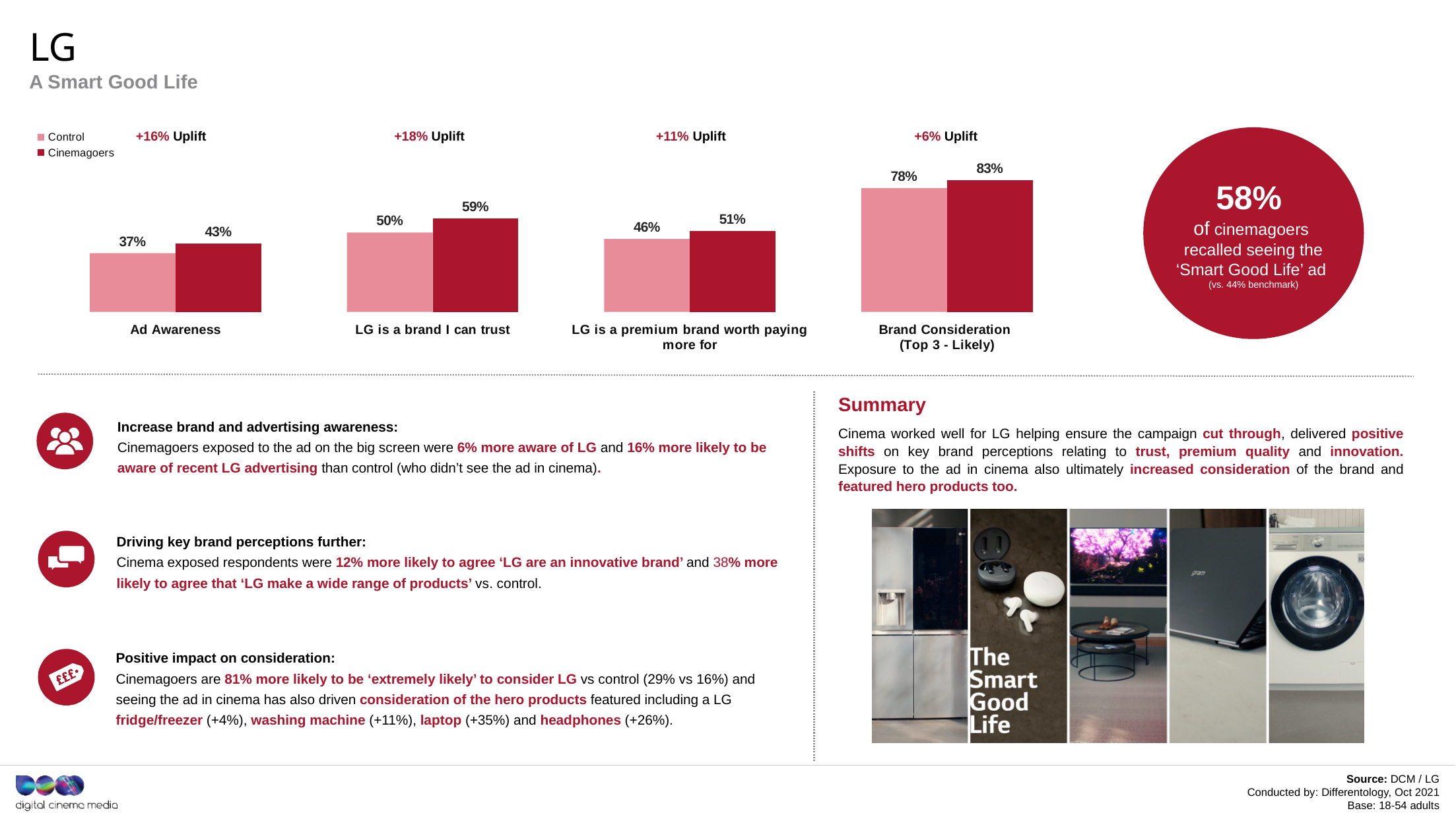
In the 'LG is a brand I can trust' chart, what is the value for Cinemagoers? 59% In the 'LG is a brand I can trust' chart, what is the difference between the Cinemagoers and Control values? 9% In the 'LG is a premium brand worth paying more for' chart, what is the value for Control? 46% Across the four bar charts, which measure has the lowest Control value? Ad Awareness In the 'Brand Consideration (Top 3 - Likely)' chart, what is the difference between the Cinemagoers and Control values? 5% In the Ad Awareness chart, what is the value for Cinemagoers? 43% In the 'LG is a premium brand worth paying more for' chart, which is larger, the Control value or the Cinemagoers value? Cinemagoers What type of chart is used to show the Control and Cinemagoers values? Bar chart Across the four bar charts, which measure has the highest Cinemagoers value? Brand Consideration (Top 3 - Likely) How many series does the legend list for the bar charts? 2 In the Ad Awareness chart, what is the value for Control? 37% In the 'Brand Consideration (Top 3 - Likely)' chart, what is the value for Cinemagoers? 83%